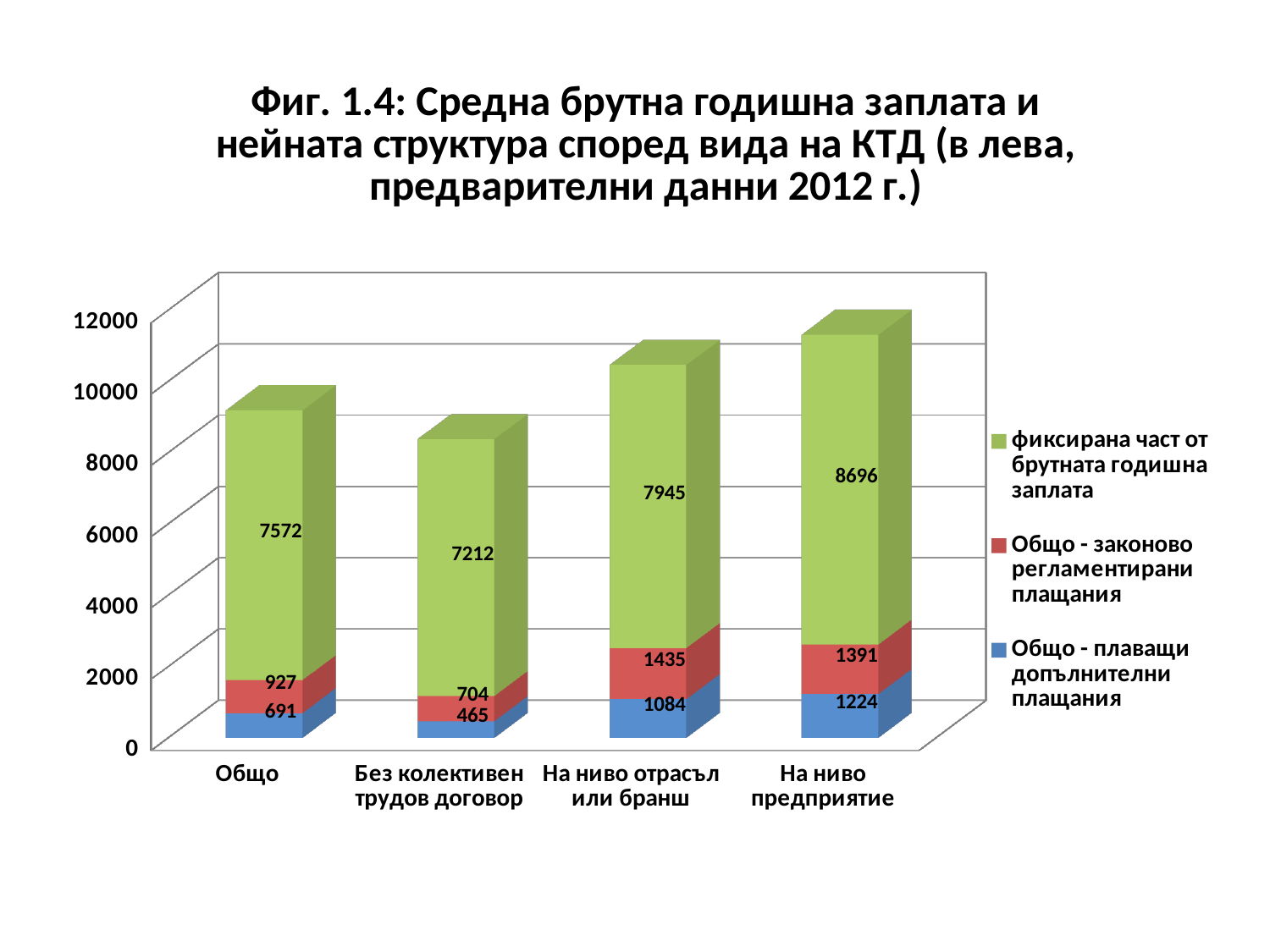
What is the total of the stacked bar for 'Общо'? 9190 What kind of chart is shown on the slide? Stacked bar chart What is the value of 'Общо - законово регламентирани плащания' for 'На ниво отрасъл или бранш'? 1435 How many categories are shown on the x axis? 4 What is the value of the fixed part of gross annual salary (фиксирана част от брутната годишна заплата) for 'На ниво предприятие'? 8696 What is the value of 'Общо - плаващи допълнителни плащания' for 'Без колективен трудов договор'? 465 Which category has the highest value for the fixed part of gross annual salary (фиксирана част от брутната годишна заплата)? На ниво предприятие What is the difference between the fixed part of gross annual salary for 'На ниво предприятие' and for 'Без колективен трудов договор'? 1484 Which category has the lowest value for 'Общо - плаващи допълнителни плащания'? Без колективен трудов договор How many series does the legend list? 3 Which is larger: 'Общо - законово регламентирани плащания' for 'Общо' or for 'Без колективен трудов договор'? Общо What is the total of the stacked bar for 'На ниво отрасъл или бранш'? 10464